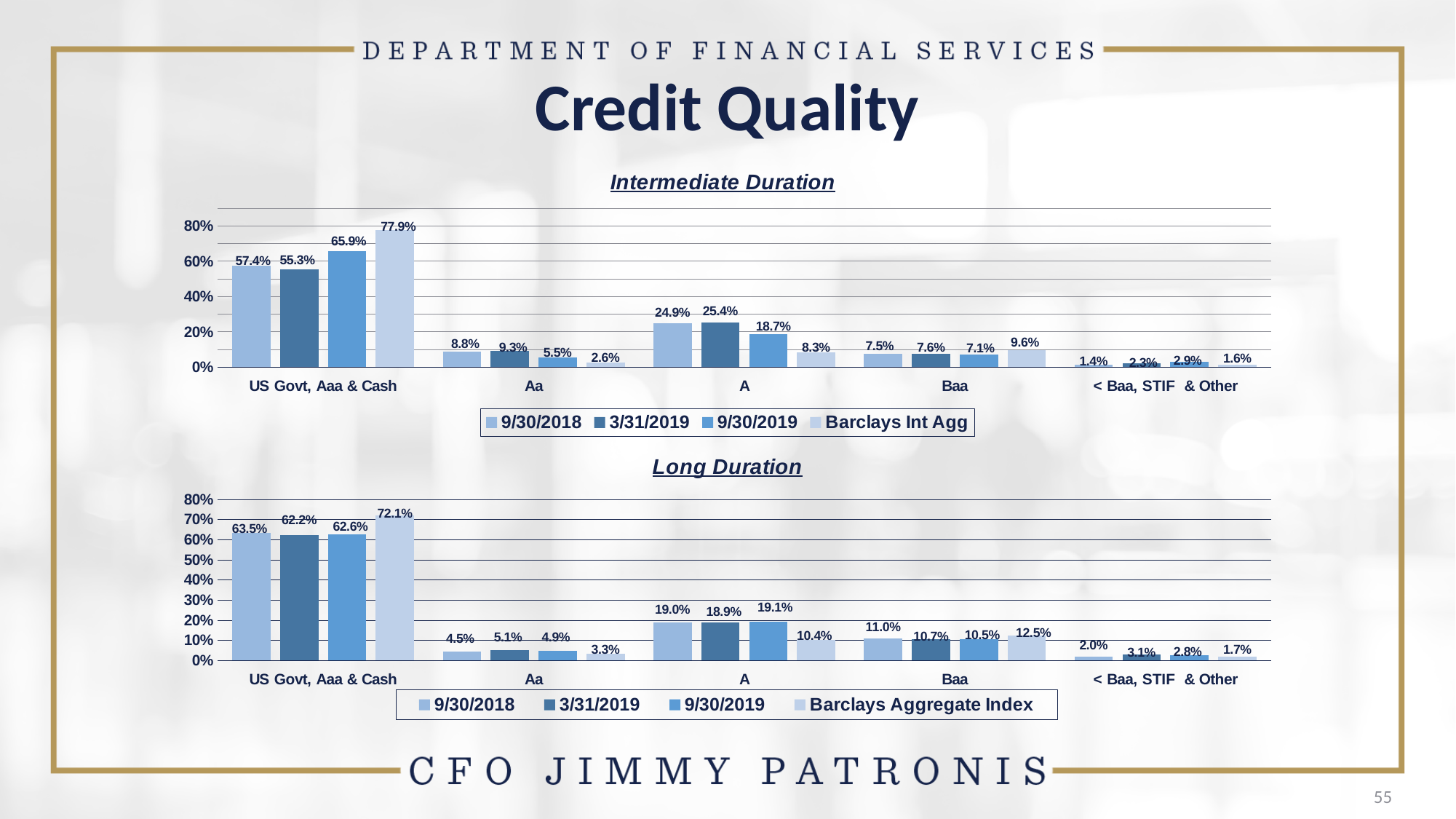
In the Intermediate Duration chart, what is the value for Barclays Int Agg in the US Govt, Aaa & Cash category? 77.9% How many categories are shown on the x axis of the Long Duration chart? 5 In the Long Duration chart, what is the Barclays Aggregate Index value for the Aa category? 3.3% In the Intermediate Duration chart, what is the difference between the 9/30/2019 and 9/30/2018 values for US Govt, Aaa & Cash? 8.5% In the Long Duration chart, what is the 3/31/2019 value for the Baa category? 10.7% In the Intermediate Duration chart, which category has the highest 9/30/2018 value? US Govt, Aaa & Cash How many series does the legend of the Intermediate Duration chart list? 4 In the Long Duration chart, which is larger for the Baa category: the 9/30/2018 value or the Barclays Aggregate Index value? Barclays Aggregate Index In the Intermediate Duration chart, is the 3/31/2019 value for the A category greater or less than 20%? greater In the Intermediate Duration chart, what is the 9/30/2019 value for the A category? 18.7% What type of chart is the Long Duration chart? Bar chart In the Long Duration chart, which category has the lowest Barclays Aggregate Index value? < Baa, STIF & Other